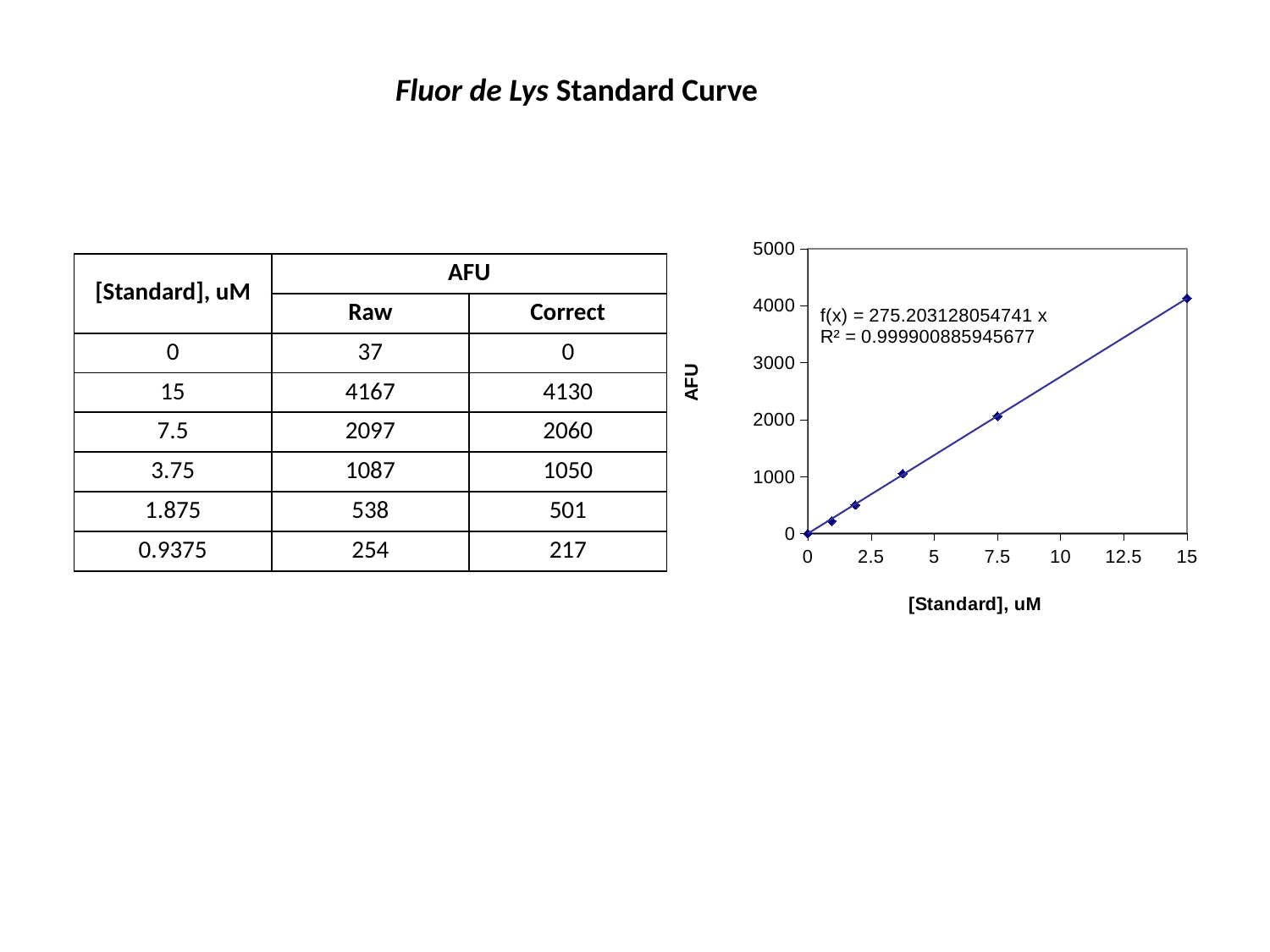
What is the equation of the trendline shown on the chart? f(x) = 275.203128054741 x Is the AFU value at 15 uM greater or less than 4000? greater Which plotted point has the lowest AFU value? 0 uM Do the AFU values rise or fall as [Standard], uM increases along the x axis? rise What R² value is shown on the chart? 0.999900885945677 Is the AFU value at 7.5 uM larger or smaller than the value at 3.75 uM? larger What kind of chart is shown on the slide? scatter chart How many data points are plotted on the chart? 6 What is the highest tick value shown on the y axis of the chart? 5000 Which plotted point has the highest AFU value? 15 uM Is the AFU value at 7.5 uM greater or less than 3000? less Is the AFU value at 1.875 uM greater or less than 1000? less